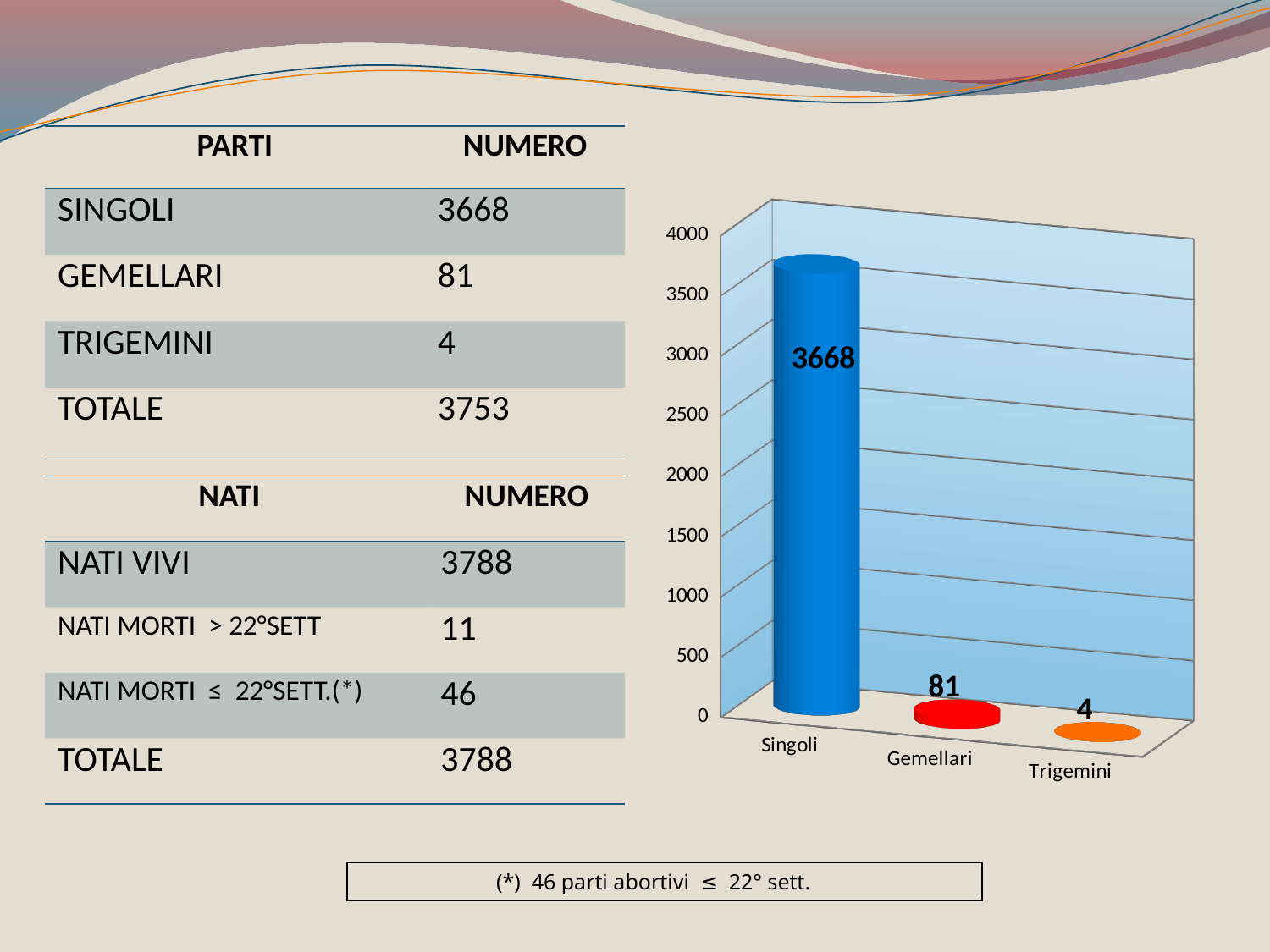
What kind of chart is shown on the slide? bar chart Which category has the lowest value in the chart? Trigemini What is the value for Singoli in the chart? 3668 Is the value for Singoli greater or less than 3500? greater What is the difference between the values for Singoli and Gemellari? 3587 What colour is the bar for Gemellari? red What is the value for Trigemini in the chart? 4 How many categories are shown on the x axis of the chart? 3 Which category has the highest value in the chart? Singoli What is the difference between the values for Gemellari and Trigemini? 77 Which is larger, the value for Gemellari or the value for Trigemini? Gemellari What is the value for Gemellari in the chart? 81